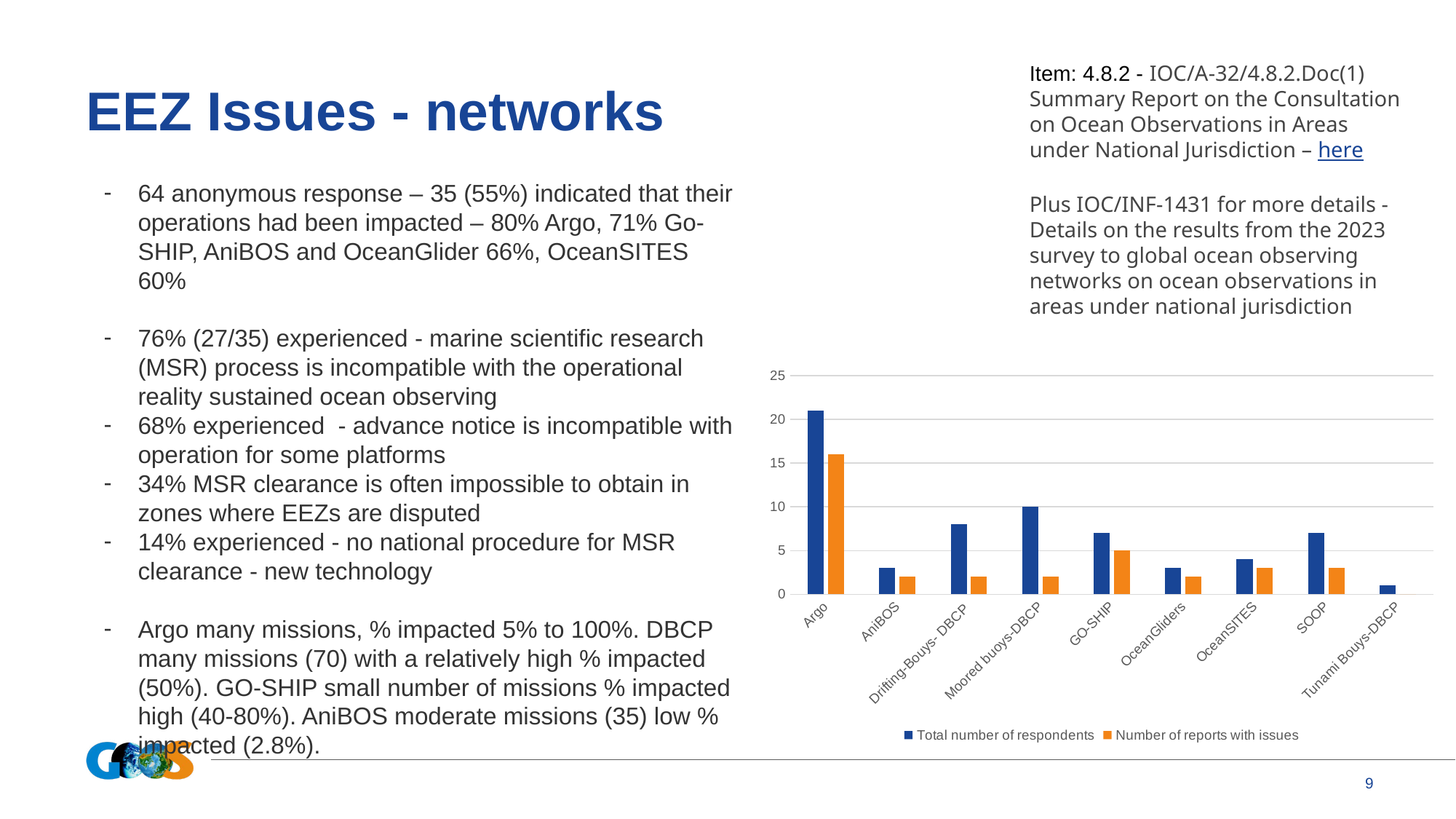
Which has more total respondents, Moored buoys-DBCP or OceanSITES? Moored buoys-DBCP Is the total number of respondents for SOOP greater or less than 5? greater What colour are the bars for 'Number of reports with issues'? orange What kind of chart is shown on the slide? bar chart How many network categories are shown on the x axis of the chart? 9 How many series does the chart legend list? 2 Which network has the highest number of reports with issues? Argo Is the total number of respondents for Argo greater or less than 20? greater Which network has the highest total number of respondents? Argo Is the total number of respondents for Drifting-Bouys- DBCP greater or less than 10? less Which network has the lowest total number of respondents? Tunami Bouys-DBCP